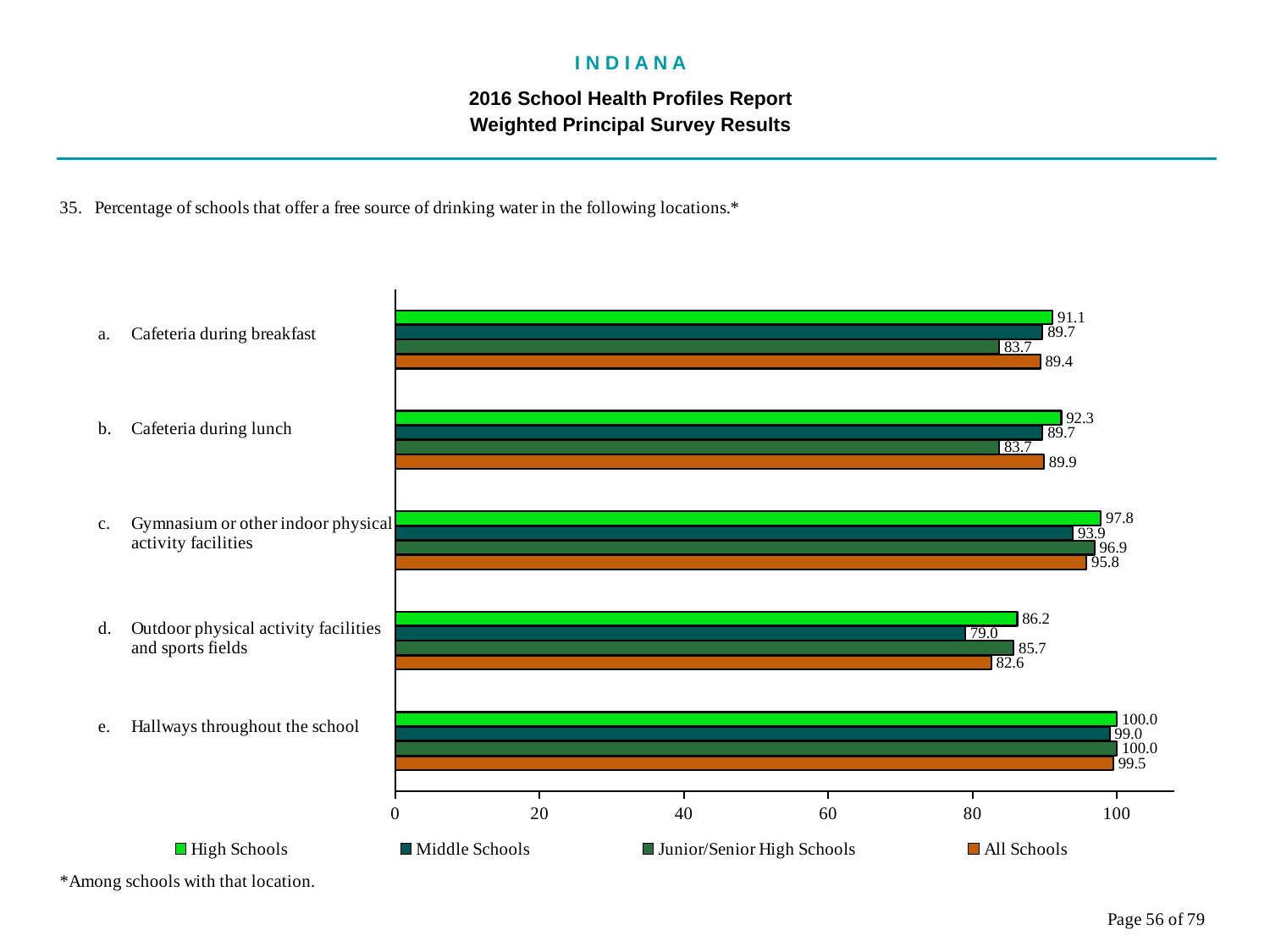
Which location has the lowest value for Middle Schools? Outdoor physical activity facilities and sports fields Which location has the highest value for All Schools? Hallways throughout the school What is the difference between the High Schools and Middle Schools values for 'Outdoor physical activity facilities and sports fields'? 7.2 What kind of chart is shown on the slide? Bar chart What is the value for Junior/Senior High Schools for 'Cafeteria during lunch'? 83.7 Which is larger for 'Gymnasium or other indoor physical activity facilities': the Middle Schools value or the Junior/Senior High Schools value? Junior/Senior High Schools What is the value for High Schools for 'Cafeteria during breakfast'? 91.1 How many locations (categories) are shown on the chart? 5 What is the value for All Schools for 'Gymnasium or other indoor physical activity facilities'? 95.8 How many series does the legend list? 4 What is the value for Middle Schools for 'Outdoor physical activity facilities and sports fields'? 79.0 Is the All Schools value for 'Outdoor physical activity facilities and sports fields' greater or less than 80? greater